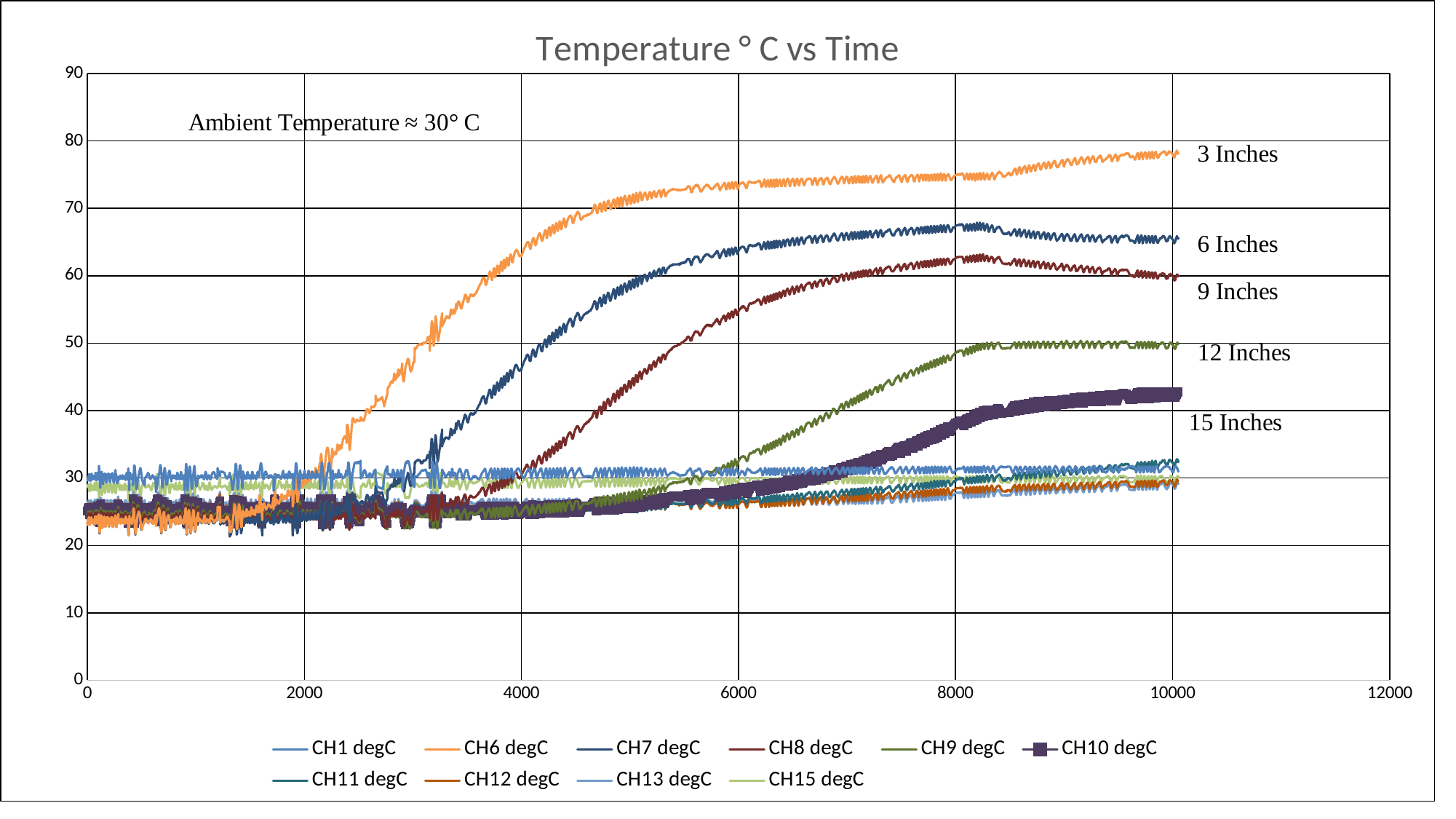
Is the value of CH10 degC at time 10000 greater or less than 40? greater What kind of chart is shown on the slide? line chart At time 10000, which series has the larger value, CH6 degC or CH9 degC? CH6 degC How many series does the legend list? 10 Is the value of CH6 degC at time 10000 greater or less than 70? greater Is the value of CH8 degC at time 6000 greater or less than 50? greater What ambient temperature is noted on the chart? ≈ 30° C What is the title of the chart? Temperature ° C vs Time Does the CH6 degC series rise or fall as time increases from 2000 to 10000? rises Which series reaches the highest temperature on the chart? CH6 degC